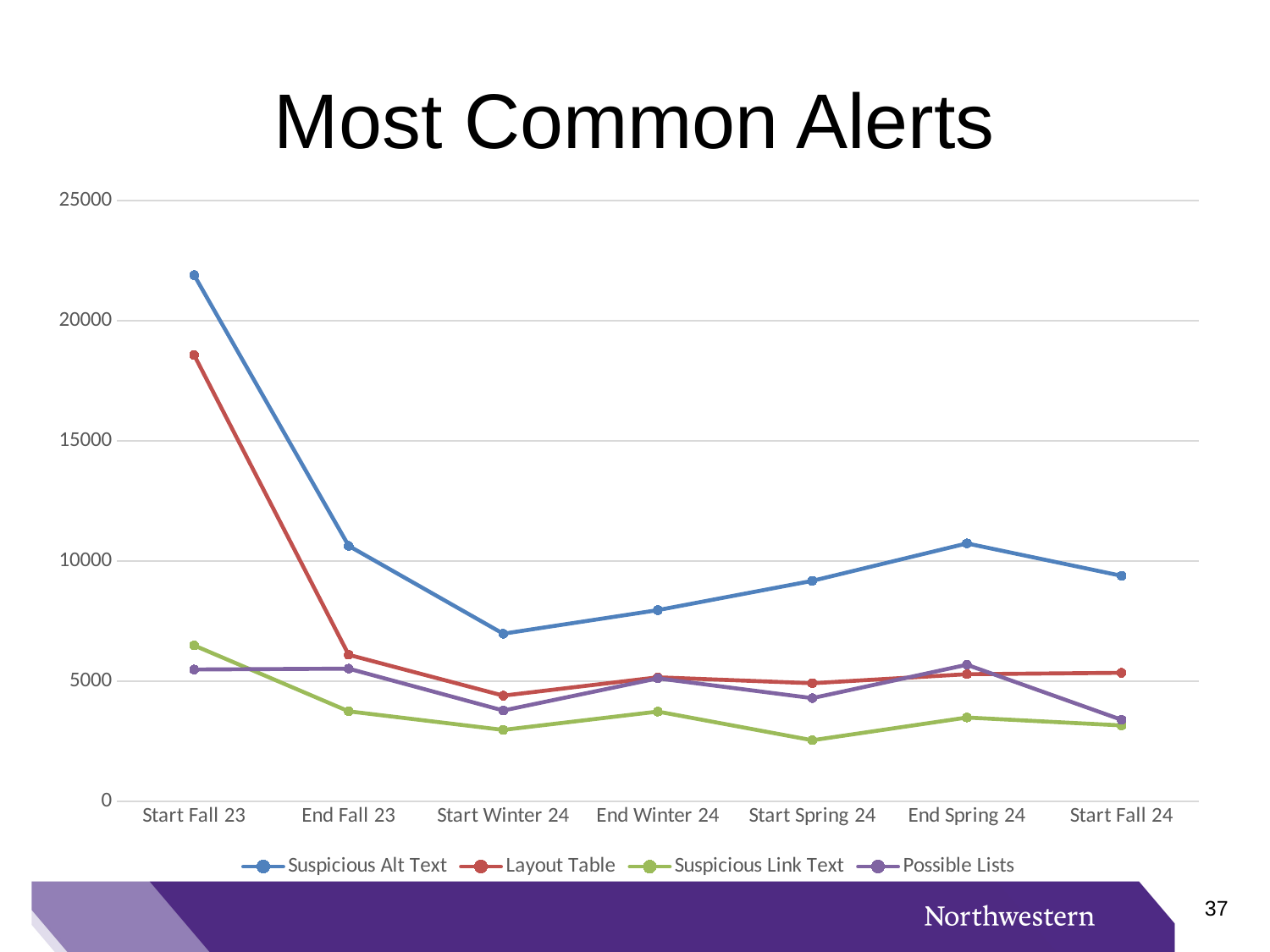
How many series does the legend list? 4 Which series has the lowest value at Start Spring 24? Suspicious Link Text Is the value for Layout Table at Start Fall 23 greater or less than 15000? greater What kind of chart is shown on the slide? line chart Which series has the highest value at Start Fall 23? Suspicious Alt Text At which point on the x axis is Suspicious Alt Text highest? Start Fall 23 Is the value for Layout Table at End Fall 23 greater or less than 10000? less Is the value for Suspicious Alt Text at Start Fall 23 greater or less than 20000? greater How many points along the x axis does each line have? 7 What is the title of the chart? Most Common Alerts At End Spring 24, which is larger: Suspicious Alt Text or Layout Table? Suspicious Alt Text Does the Suspicious Alt Text line rise or fall from Start Fall 23 to Start Winter 24? fall